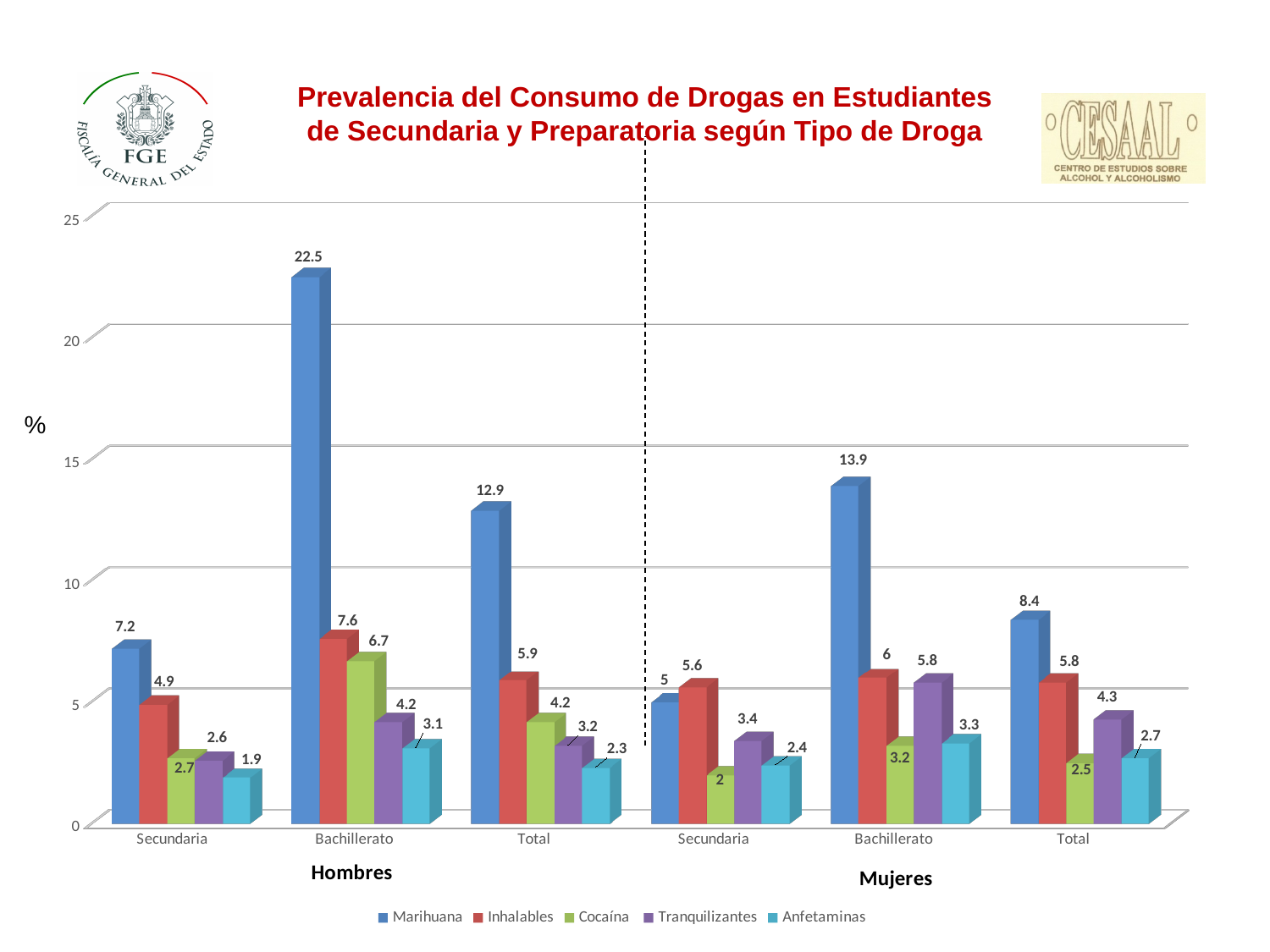
Is the Marihuana value for Total among Hombres greater or less than 10? greater What is the difference between the Marihuana values for Bachillerato among Hombres and Bachillerato among Mujeres? 8.6 How many series does the legend list? 5 How many category groups are shown on the x axis? 6 Which drug has the highest prevalence for Bachillerato among Mujeres? Marihuana Which colour represents Cocaína in the legend? Green Which drug has the lowest prevalence for Secundaria among Hombres? Anfetaminas What is the Marihuana value for Bachillerato among Hombres? 22.5 Which is larger: the Tranquilizantes value for Total among Hombres or for Total among Mujeres? Total among Mujeres What is the Inhalables value for Total among Mujeres? 5.8 What kind of chart is shown on the slide? Bar chart What is the Cocaína value for Secundaria among Mujeres? 2